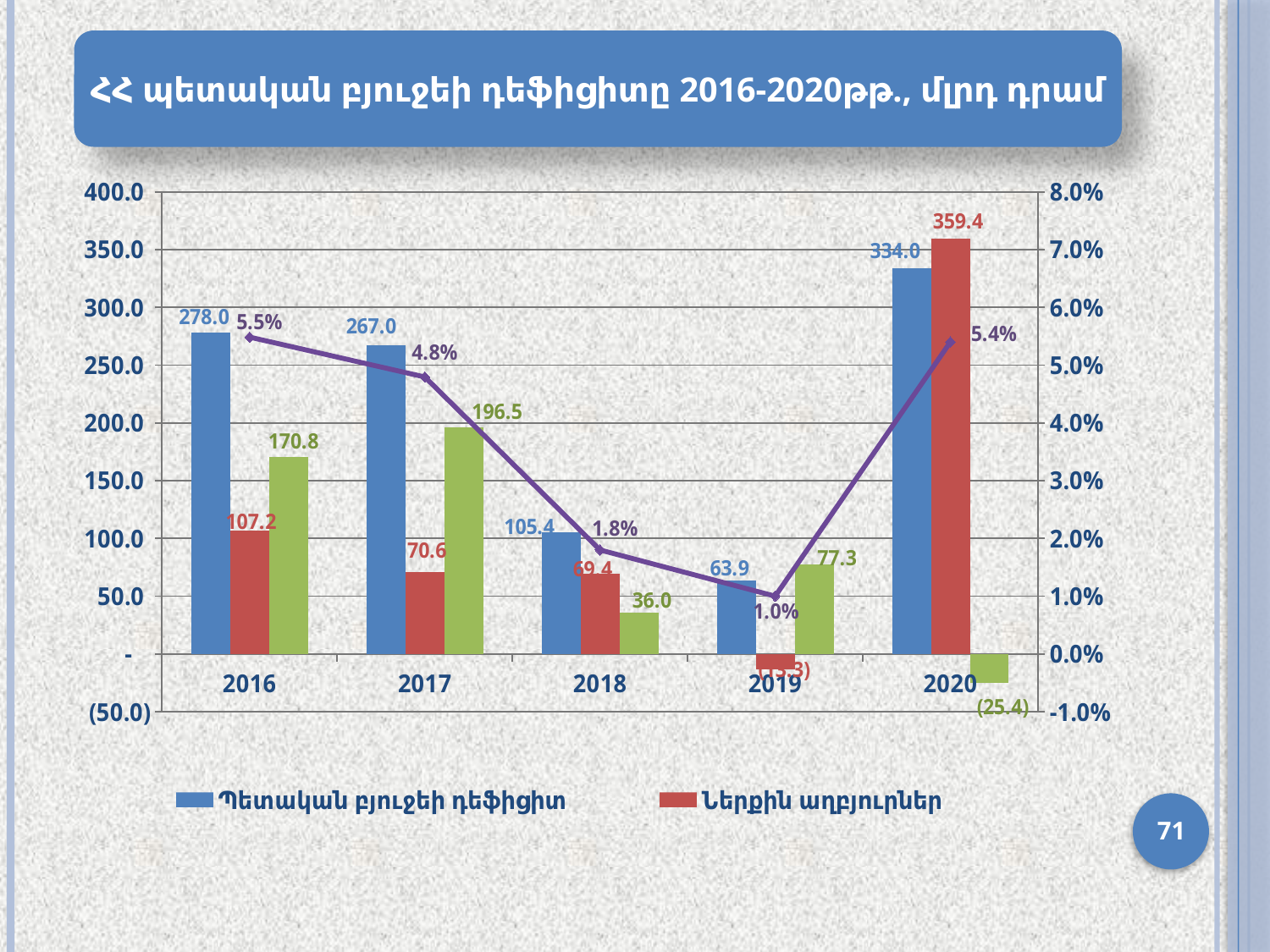
What percentage does the purple line show for 2018? 1.8% How many years are shown on the x axis? 5 Does the purple line rise or fall from 2016 to 2019? Fall How many series does the legend list? 2 What kind of chart is this? A bar chart combined with a line In which year is the blue bar (Պետական բյուջեի դեֆիցիտ) lowest? 2019 In 2020, which is larger: the blue bar or the red bar? The red bar (359.4) What is the value of the red bar (Ներքին աղբյուրներ) for 2020? 359.4 In which year is the blue bar (Պետական բյուջեի դեֆիցիտ) highest? 2020 What is the difference between the blue bar values for 2020 and 2016? 56.0 What is the value of the blue bar (Պետական բյուջեի դեֆիցիտ) for 2016? 278.0 What is the value of the green bar for 2017? 196.5